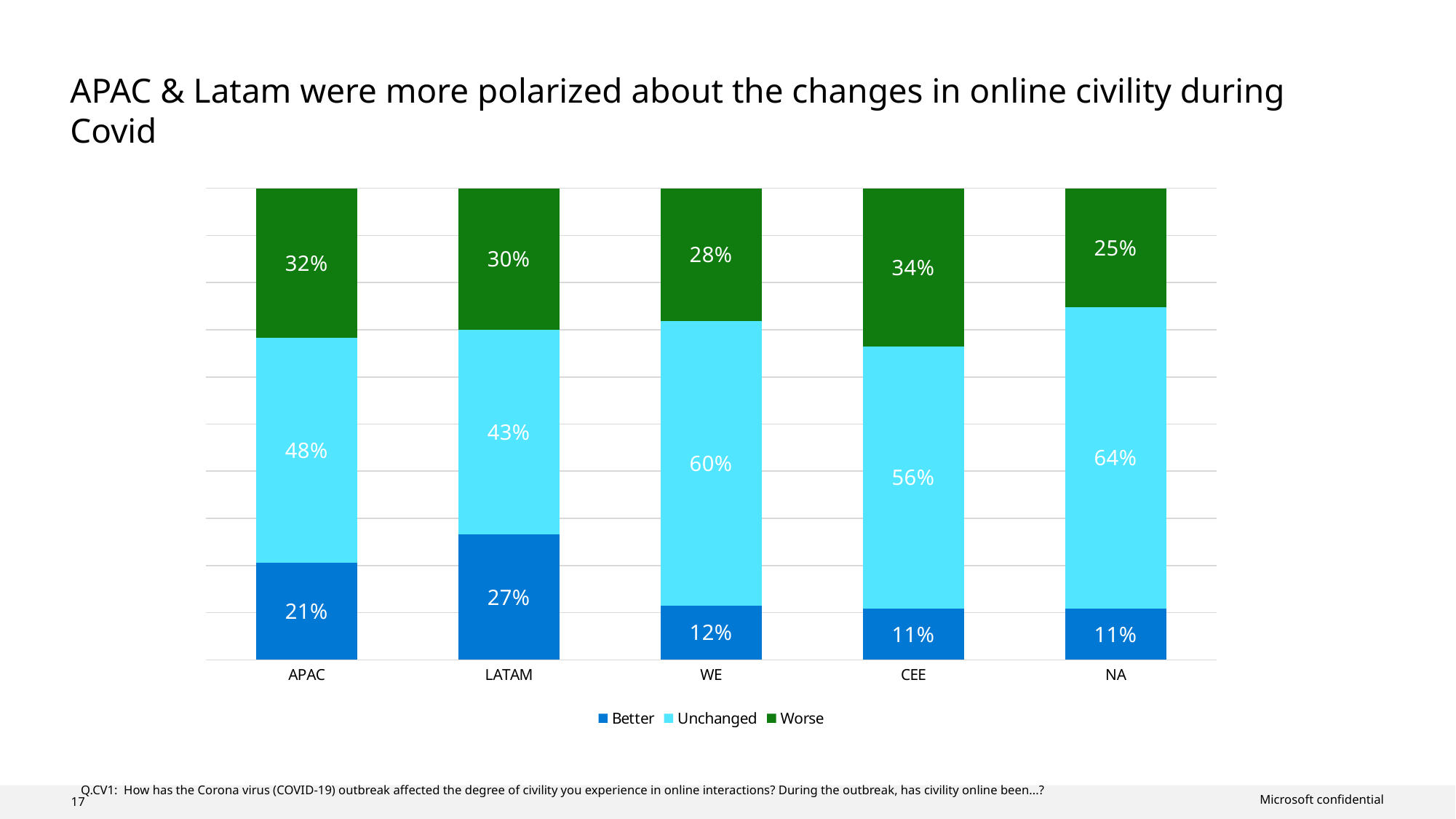
What is the difference between the Unchanged values for WE and APAC? 12% How many series does the legend list? 3 What kind of chart is shown on the slide? Stacked bar chart What percentage of APAC respondents said online civility was Better? 21% What is the Worse value for CEE? 34% Which region has the lowest Unchanged value? LATAM Which is larger, the Worse value for APAC or the Worse value for LATAM? APAC How many regions are shown on the x axis? 5 Which region has the highest Better value? LATAM Which series is shown in dark green in the legend? Worse Which region has the lowest Worse value? NA What is the Unchanged value for NA? 64%